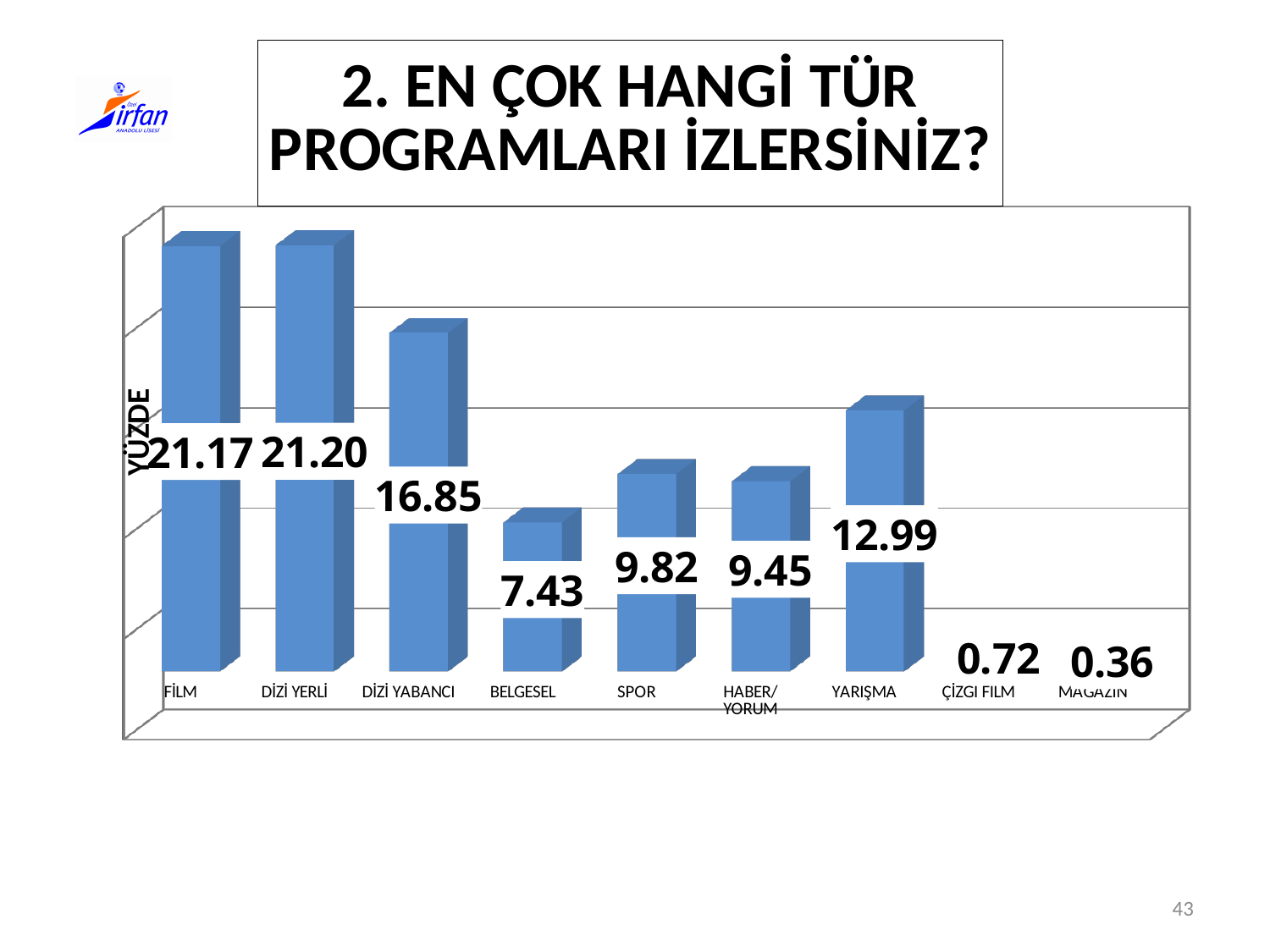
What is the value for YARIŞMA? 12.99 What is the difference between the values for FİLM and BELGESEL? 13.74 Which category has the highest value? DİZİ YERLİ How many categories are shown in the chart? 9 What is the value for BELGESEL? 7.43 What is the label on the vertical axis of the chart? YÜZDE What is the value for FİLM? 21.17 What is the difference between the values for SPOR and HABER/YORUM? 0.37 Which is larger, the value for DİZİ YABANCI or the value for YARIŞMA? DİZİ YABANCI What is the value for ÇİZGİ FILM? 0.72 What kind of chart is shown on the slide? Bar chart Which category has the lowest value? MAGAZİN